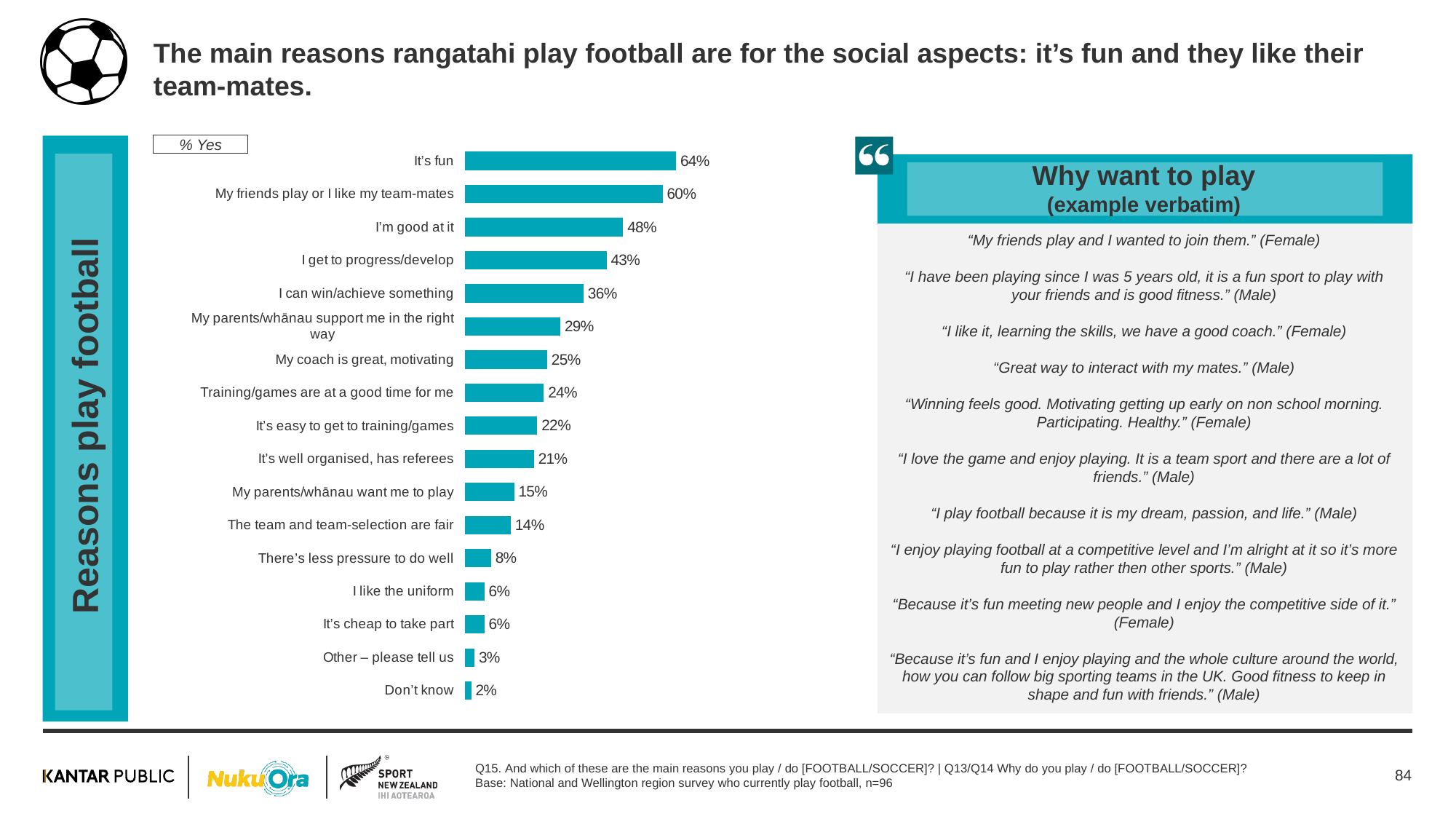
Which reason has the highest percentage? It's fun How many reason categories are shown in the bar chart? 17 What is the difference between "It's fun" and "My friends play or I like my team-mates"? 4 percentage points What type of chart is used to show the reasons for playing football? Bar chart Do the values rise or fall going down the list of categories from top to bottom? Fall What is the value for "My coach is great, motivating"? 25% What label appears in the box above the bar chart indicating what the values represent? % Yes Which is larger: "I can win/achieve something" or "My parents/whānau support me in the right way"? I can win/achieve something What is the difference between "I'm good at it" and "I get to progress/develop"? 5 percentage points What percentage of respondents said they play football because it's fun? 64% What percentage said "My parents/whānau want me to play"? 15% Which category has the lowest percentage? Don't know